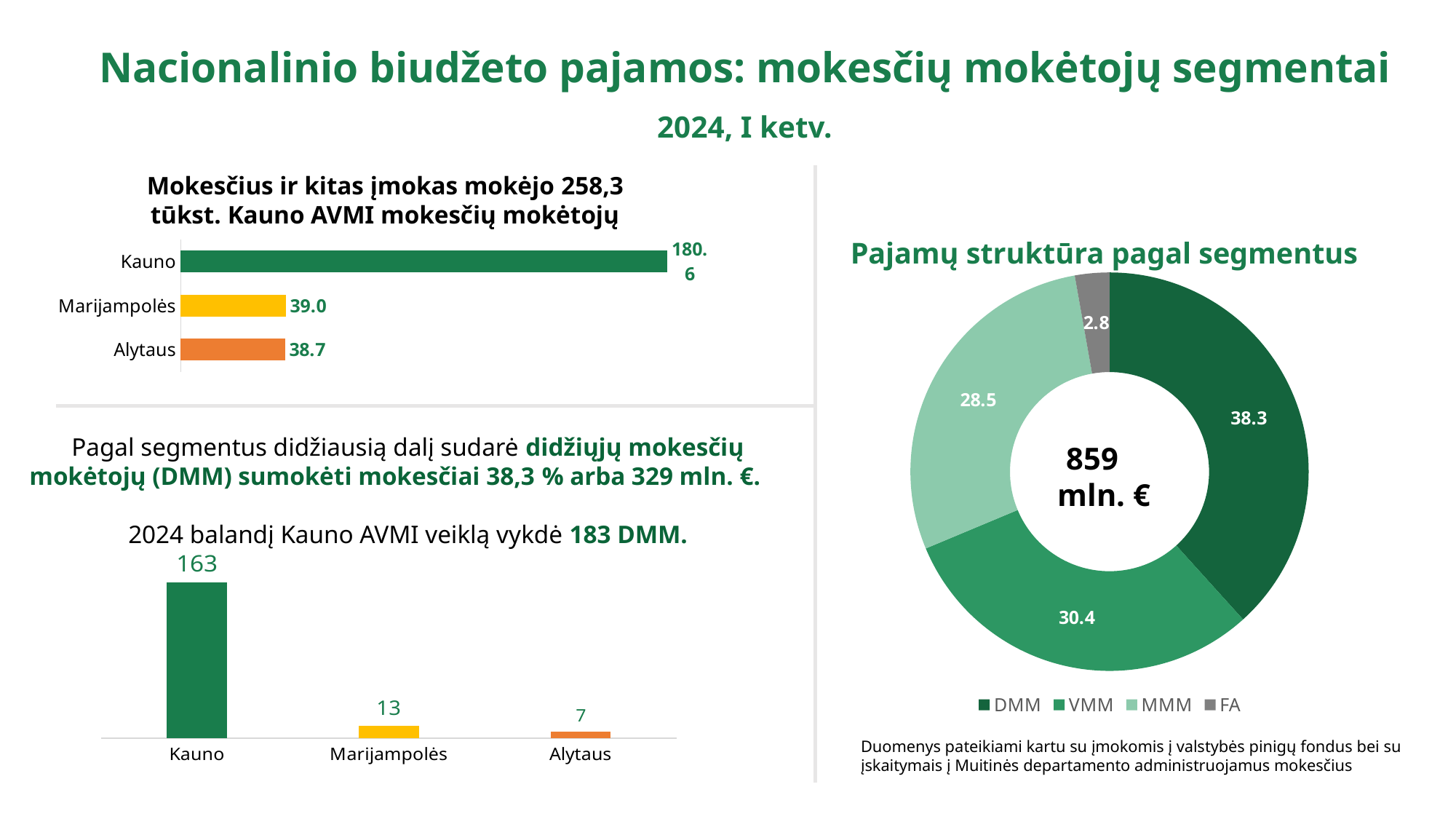
In the top-left bar chart, what is the value for Kauno? 180.6 What kind of chart is the top-left chart? Bar chart In the bottom-left bar chart, which category has the lowest value? Alytaus In the bottom-left bar chart, how many categories are shown? 3 In the top-left bar chart, what is the difference between the values for Kauno and Marijampolės? 141.6 In the bottom-left bar chart, what is the difference between the values for Kauno and Alytaus? 156 In the top-left bar chart, what is the value for Alytaus? 38.7 In the top-left bar chart, which category has the highest value? Kauno In the bottom-left bar chart (2024 balandį Kauno AVMI veiklą vykdė 183 DMM.), what is the value for Marijampolės? 13 In the chart titled 'Pajamų struktūra pagal segmentus', which segment has the smallest value? FA How many series does the legend of the chart titled 'Pajamų struktūra pagal segmentus' list? 4 In the chart titled 'Pajamų struktūra pagal segmentus', what is the value for VMM? 30.4